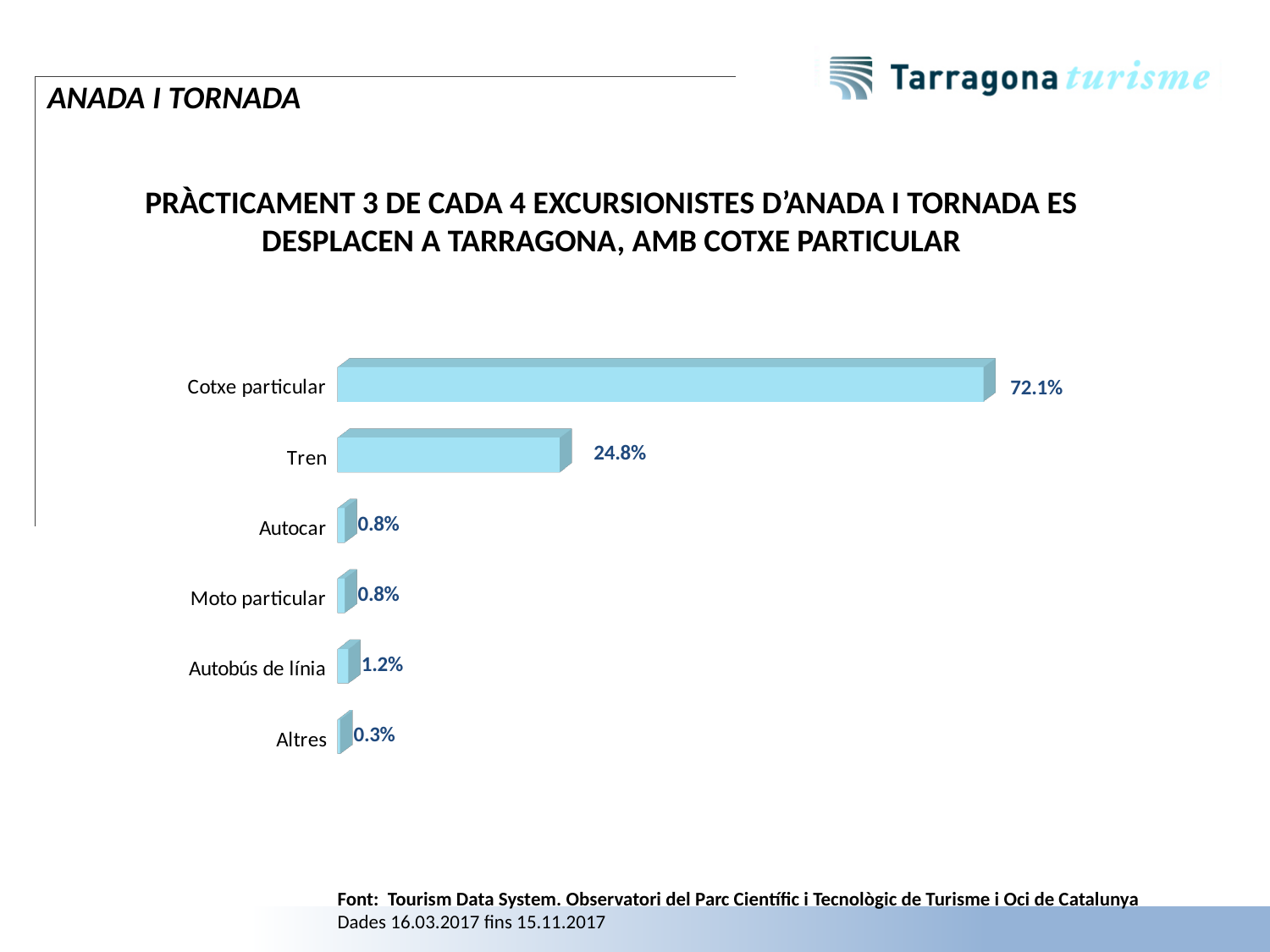
What kind of chart is shown on the slide? Bar chart How many categories are shown in the chart? 6 Which two categories share the same value of 0.8%? Autocar and Moto particular What is the difference between the values for Autobús de línia and Altres? 0.9% What is the difference between the values for Cotxe particular and Tren? 47.3% Which category has the lowest value? Altres What is the value for Altres? 0.3% Which is larger, the value for Tren or the value for Autobús de línia? Tren What is the value for Autobús de línia? 1.2% What is the value for Tren? 24.8% What is the value for Cotxe particular? 72.1% Which category has the highest value? Cotxe particular